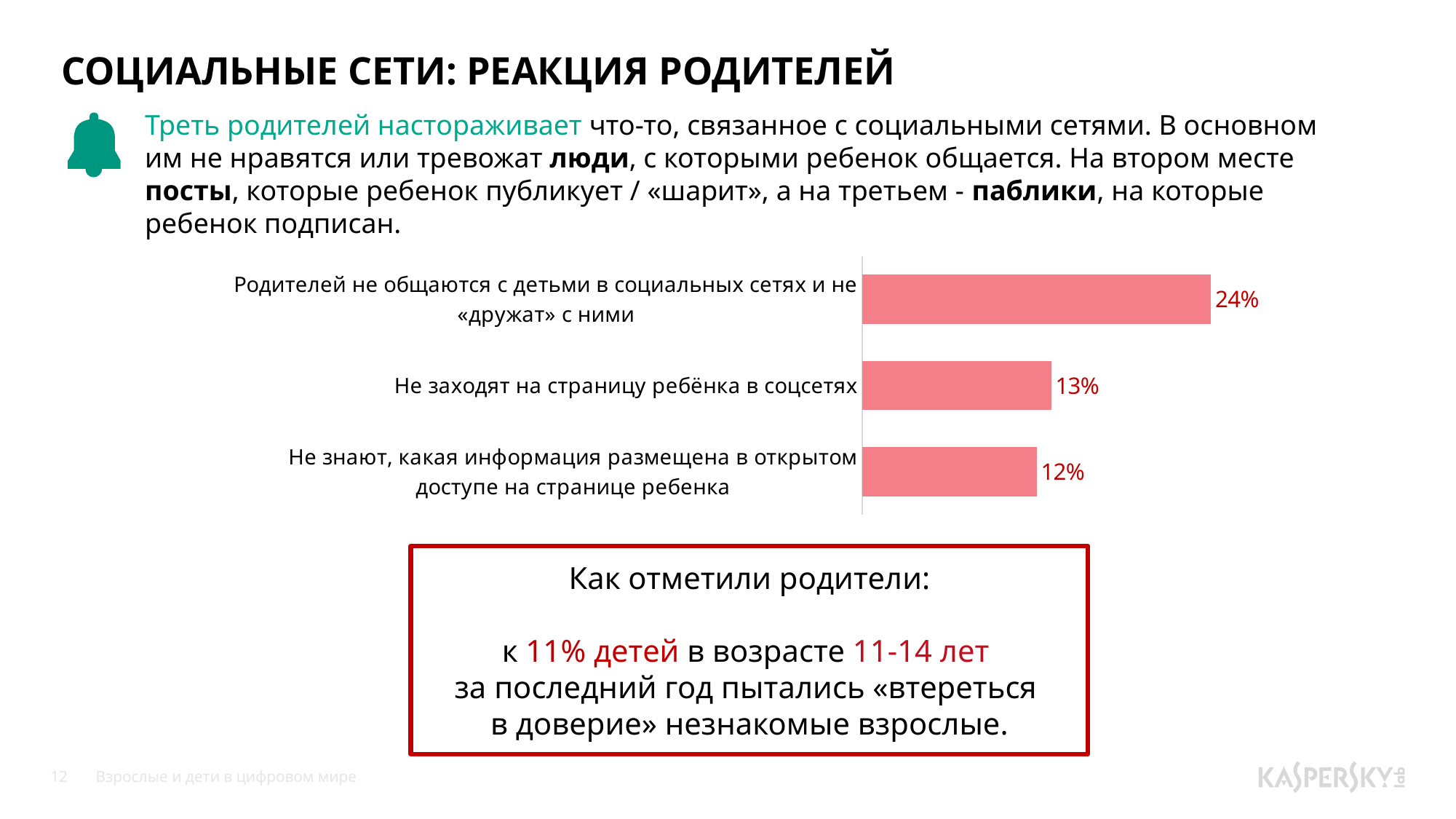
Which category has the highest value in the chart? Родителей не общаются с детьми в социальных сетях и не «дружат» с ними Which category has the lowest value in the chart? Не знают, какая информация размещена в открытом доступе на странице ребенка Which is larger: the value for parents who do not communicate with children on social networks, or the value for parents who do not visit the child's page? Родителей не общаются с детьми в социальных сетях и не «дружат» с ними Are the bars in the chart oriented horizontally or vertically? Horizontally What type of chart is shown on the slide? Bar chart How many categories are shown in the chart? 3 What colour are the bars in the chart? Pink/red What is the difference between the value for parents who do not communicate with children on social networks (24%) and those who do not visit the child's page (13%)? 11% What is the value for 'Не заходят на страницу ребёнка в соцсетях'? 13% What is the difference between the values for 'Не заходят на страницу ребёнка в соцсетях' and 'Не знают, какая информация размещена в открытом доступе на странице ребенка'? 1% What percentage of parents do not communicate with their children on social networks and are not 'friends' with them? 24% What percentage of parents do not know what information is publicly available on their child's page? 12%